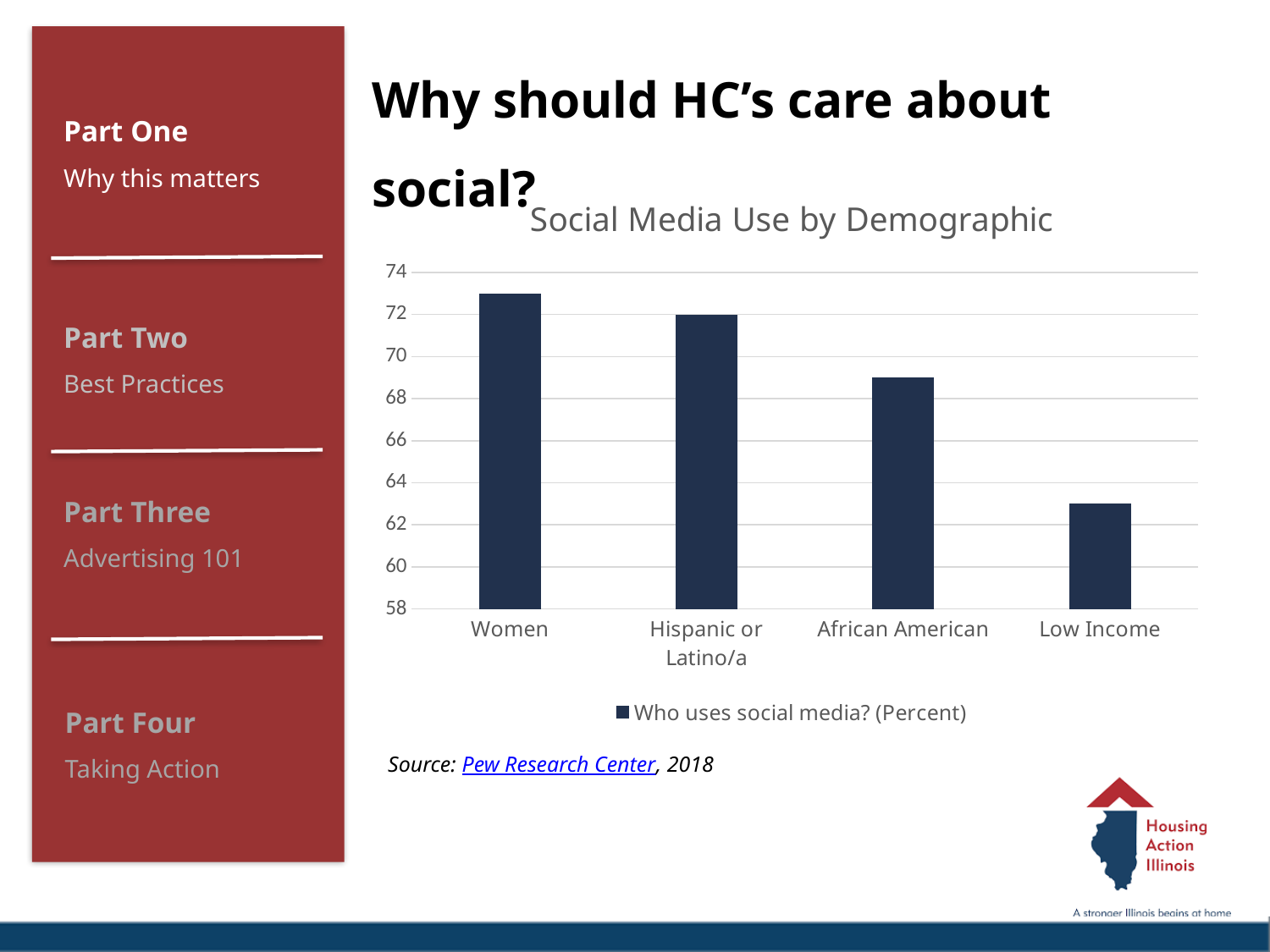
How many series does the chart's legend list? 1 Which is larger, the value for Hispanic or Latino/a or the value for African American? Hispanic or Latino/a Which demographic has the lowest social media use in the chart? Low Income How many categories are shown on the x axis of the chart? 4 What is the value for Hispanic or Latino/a in the chart? 72 Is the value for African American greater or less than 70? less What is the title of the chart? Social Media Use by Demographic Is the value for Low Income greater or less than 64? less What is the legend entry for the series in the chart? Who uses social media? (Percent) Is the value for Women greater or less than 72? greater Which demographic has the highest social media use in the chart? Women What type of chart is shown on the slide? Bar chart